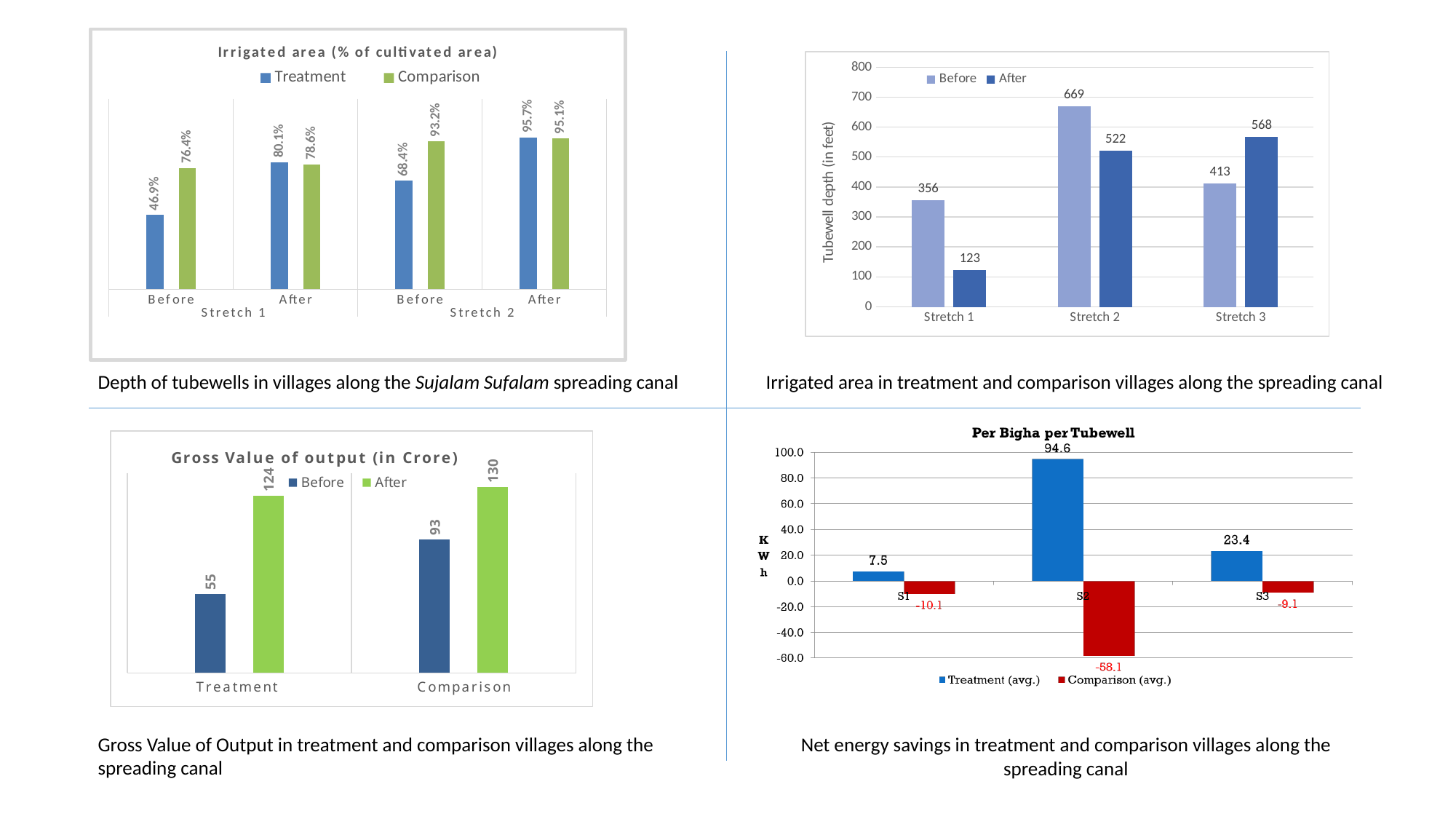
In the bottom-right chart titled "Per Bigha per Tubewell", what is the Comparison (avg.) value for S1? -10.1 In the top-right chart of tubewell depth (in feet), how many series does the legend list? 2 In the bottom-left chart titled "Gross Value of output (in Crore)", what is the After value for Treatment? 124 In the top-right chart of tubewell depth (in feet), what is the Before value for Stretch 2? 669 In the top-left chart titled "Irrigated area (% of cultivated area)", what is the Treatment value for Stretch 1 Before? 46.9% In the top-left chart titled "Irrigated area (% of cultivated area)", which is larger for Stretch 2 After: Treatment or Comparison? Treatment In the bottom-left chart titled "Gross Value of output (in Crore)", what is the difference between the Before values for Comparison and Treatment? 38 In the top-right chart of tubewell depth (in feet), what is the difference between the Before and After values for Stretch 1? 233 In the top-right chart of tubewell depth (in feet), which stretch has the lowest After value? Stretch 1 In the top-left chart titled "Irrigated area (% of cultivated area)", what is the Comparison value for Stretch 2 Before? 93.2% What kind of chart is the bottom-right chart titled "Per Bigha per Tubewell"? Bar chart In the bottom-right chart titled "Per Bigha per Tubewell", what is the Treatment (avg.) value for S2? 94.6